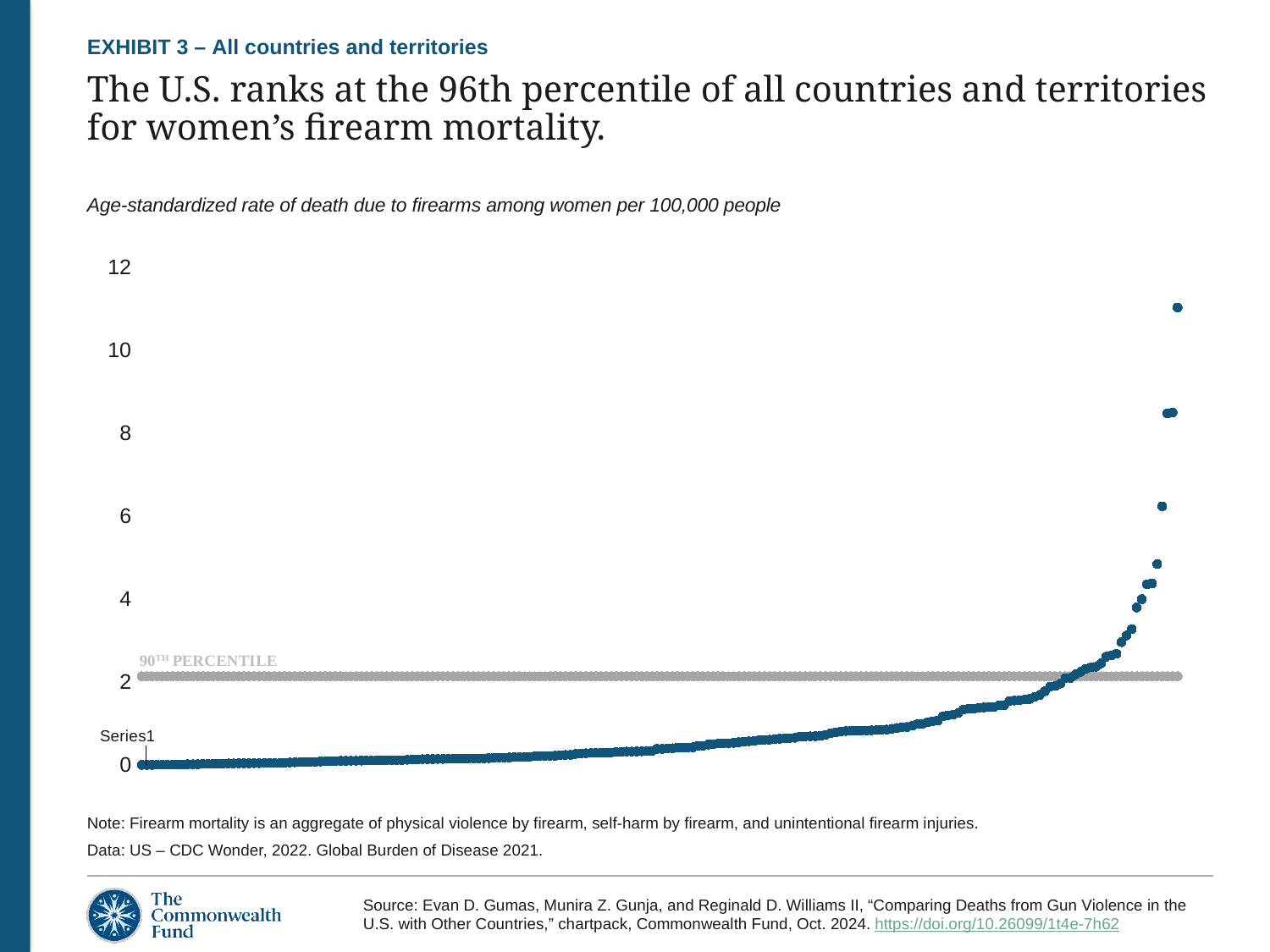
What kind of chart is shown on the slide? scatter (dot) chart What does the horizontal grey line across the chart represent? 90th percentile Is the second-highest cluster of points greater or less than 8? greater Is the highest plotted value greater or less than 12? less Is the highest plotted value greater or less than 10? greater What is the highest value shown on the y axis? 12 Do the plotted values rise or fall from left to right along the x axis? rise